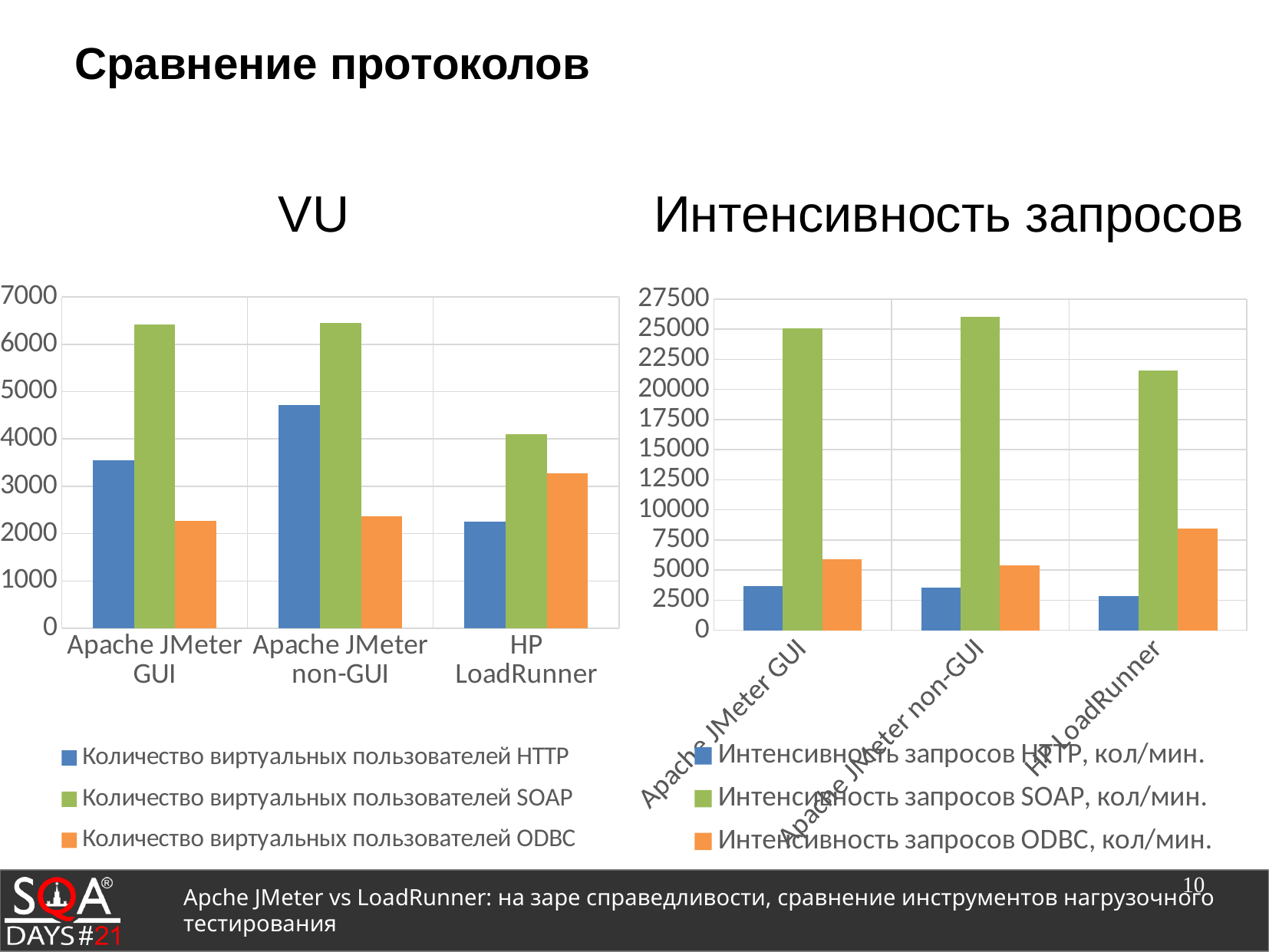
In the "VU" chart, is the value of "Количество виртуальных пользователей HTTP" for Apache JMeter non-GUI greater or less than 4000? greater How many categories are shown on the x axis of the "Интенсивность запросов" chart? 3 In the "VU" chart, for HP LoadRunner, which is larger: "Количество виртуальных пользователей SOAP" or "Количество виртуальных пользователей ODBC"? Количество виртуальных пользователей SOAP In the "Интенсивность запросов" chart, which category has the lowest value for "Интенсивность запросов SOAP, кол/мин."? HP LoadRunner In the "Интенсивность запросов" chart, is the value of "Интенсивность запросов HTTP, кол/мин." for HP LoadRunner greater or less than 5000? less In the "VU" chart, which category has the highest value for "Количество виртуальных пользователей HTTP"? Apache JMeter non-GUI In the "Интенсивность запросов" chart, which category has the highest value for "Интенсивность запросов ODBC, кол/мин."? HP LoadRunner In the "VU" chart, what colour represents "Количество виртуальных пользователей SOAP"? green In the "VU" chart, which category has the highest value for "Количество виртуальных пользователей ODBC"? HP LoadRunner What kind of chart is the "VU" chart? bar chart How many series does the legend of the "VU" chart list? 3 In the "Интенсивность запросов" chart, is the value of "Интенсивность запросов SOAP, кол/мин." for HP LoadRunner greater or less than 20000? greater